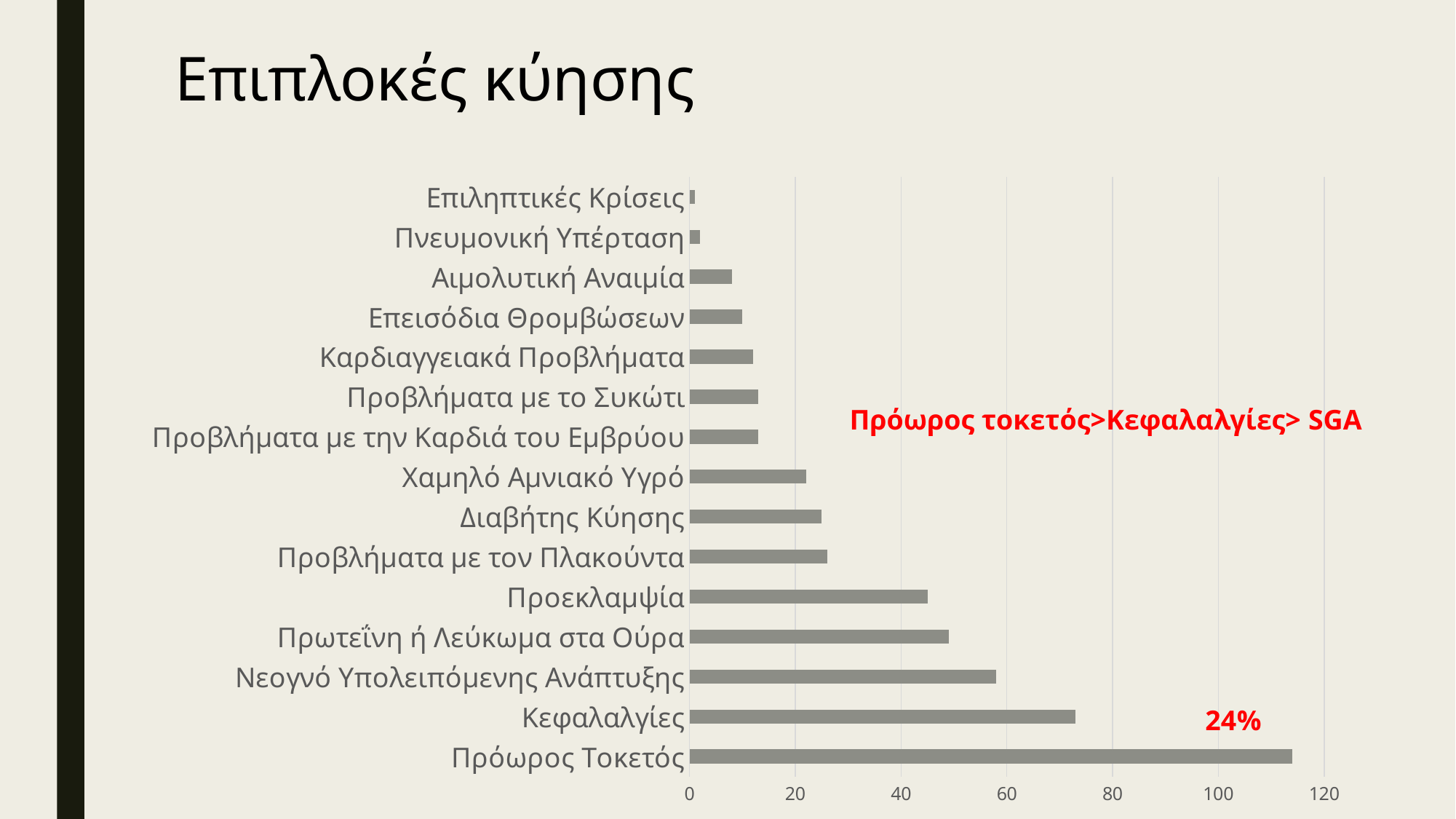
Is the value for Προεκλαμψία greater or less than 60? less Which category has the highest value in the chart? Πρόωρος Τοκετός Which has a larger value, Κεφαλαλγίες or Προεκλαμψία? Κεφαλαλγίες Which has a larger value, Αιμολυτική Αναιμία or Διαβήτης Κύησης? Διαβήτης Κύησης What percentage is written in red next to the longest bar? 24% Is the value for Νεογνό Υπολειπόμενης Ανάπτυξης greater or less than 40? greater Is the value for Πρόωρος Τοκετός greater or less than 100? greater What kind of chart is shown on the slide? bar chart How many categories (complications) are plotted in the chart? 15 What is the title of the slide containing the chart? Επιπλοκές κύησης